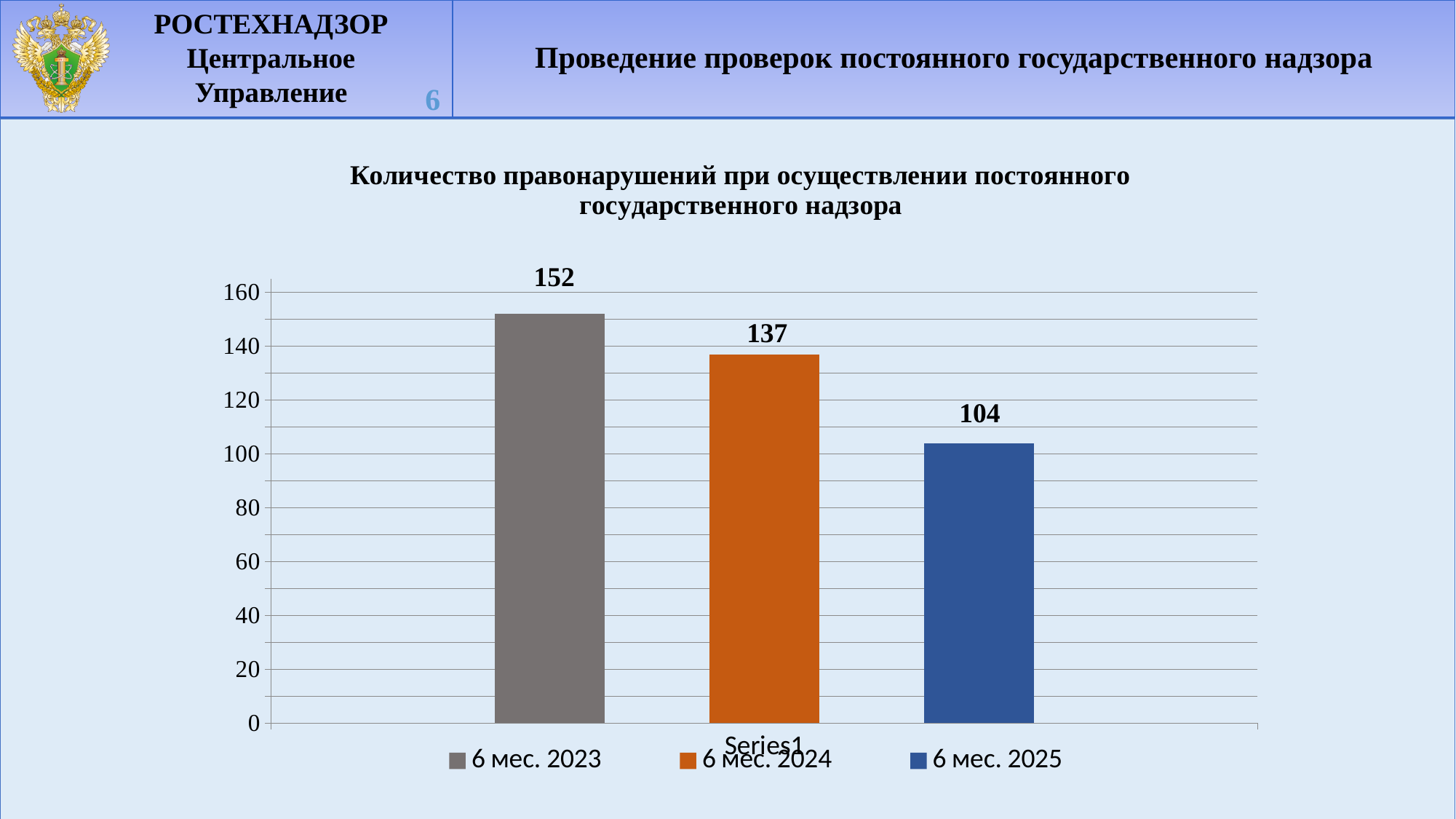
Do the values rise or fall from 6 мес. 2023 to 6 мес. 2025? fall What is the value for 6 мес. 2024? 137 What is the difference between the values for 6 мес. 2024 and 6 мес. 2025? 33 Is the value for 6 мес. 2024 greater or less than 120? greater How many series does the legend list? 3 What is the value for 6 мес. 2023? 152 Which series has the highest value? 6 мес. 2023 What is the value for 6 мес. 2025? 104 Which is larger, the value for 6 мес. 2024 or the value for 6 мес. 2025? 6 мес. 2024 What kind of chart is shown on the slide? bar chart What is the difference between the values for 6 мес. 2023 and 6 мес. 2025? 48 Which series has the lowest value? 6 мес. 2025